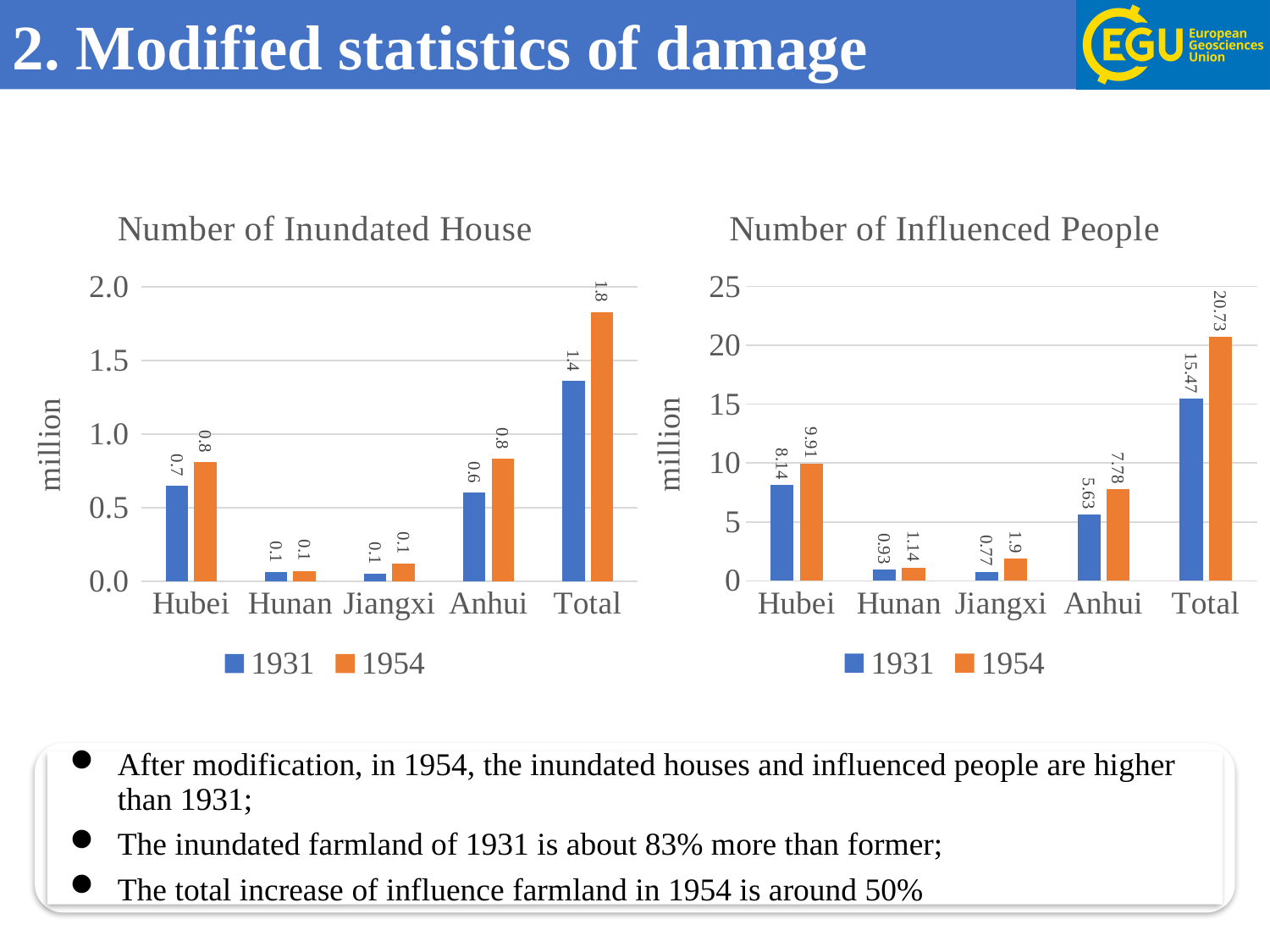
In the 'Number of Inundated House' chart, what is the Total value for 1954? 1.8 In the 'Number of Inundated House' chart, what is the value for Anhui in 1931? 0.6 In the 'Number of Inundated House' chart, what is the difference between the 1954 and 1931 values for Anhui? 0.2 In the 'Number of Influenced People' chart, which is larger for Jiangxi: the 1931 value or the 1954 value? 1954 How many series does the legend of the 'Number of Influenced People' chart list? 2 How many categories are shown on the x axis of the 'Number of Inundated House' chart? 5 In the 'Number of Influenced People' chart, is the Total value for 1954 greater or less than 20? greater In the 'Number of Influenced People' chart, what is the value for Anhui in 1931? 5.63 In the 'Number of Influenced People' chart, what is the value for Hubei in 1954? 9.91 In the 'Number of Influenced People' chart, which province (excluding Total) has the highest 1954 value? Hubei In the 'Number of Influenced People' chart, what is the difference between the Total values for 1954 and 1931? 5.26 In the 'Number of Influenced People' chart, which category has the lowest 1931 value? Jiangxi